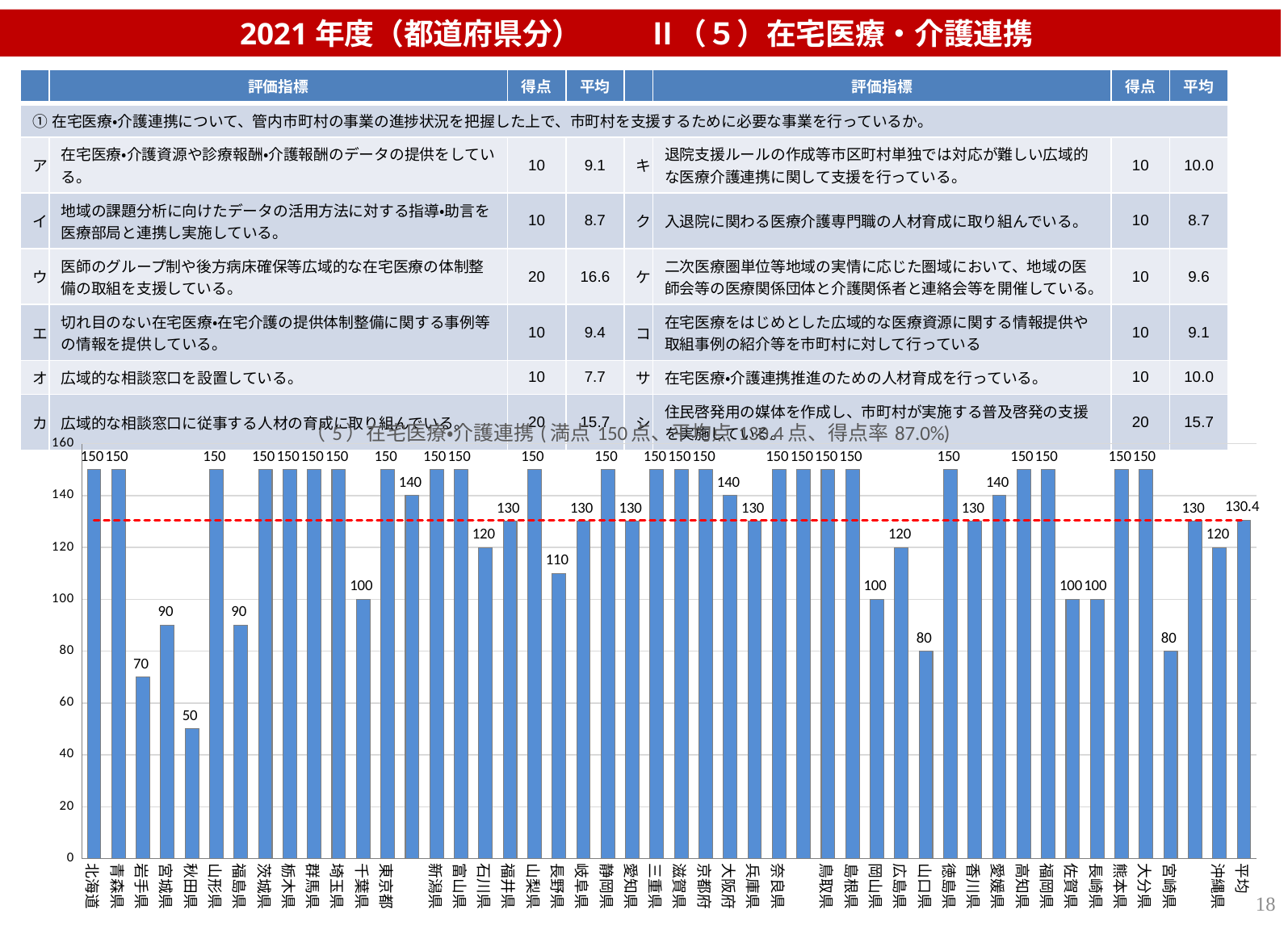
What kind of chart is shown on the slide? bar chart What is the value for 岩手県? 70 What is the value for 千葉県? 100 What is the difference between the values for 宮城県 and 秋田県? 40 Which has a larger value, 宮崎県 or 沖縄県? 沖縄県 What is the value for 秋田県? 50 What is the difference between the values for 北海道 and 岩手県? 80 Which has a larger value, 長野県 or 石川県? 石川県 What is the value shown for 平均? 130.4 According to the chart title, what is the 満点 (full score)? 150点 Which prefecture has the lowest value? 秋田県 What is the value for 山口県? 80